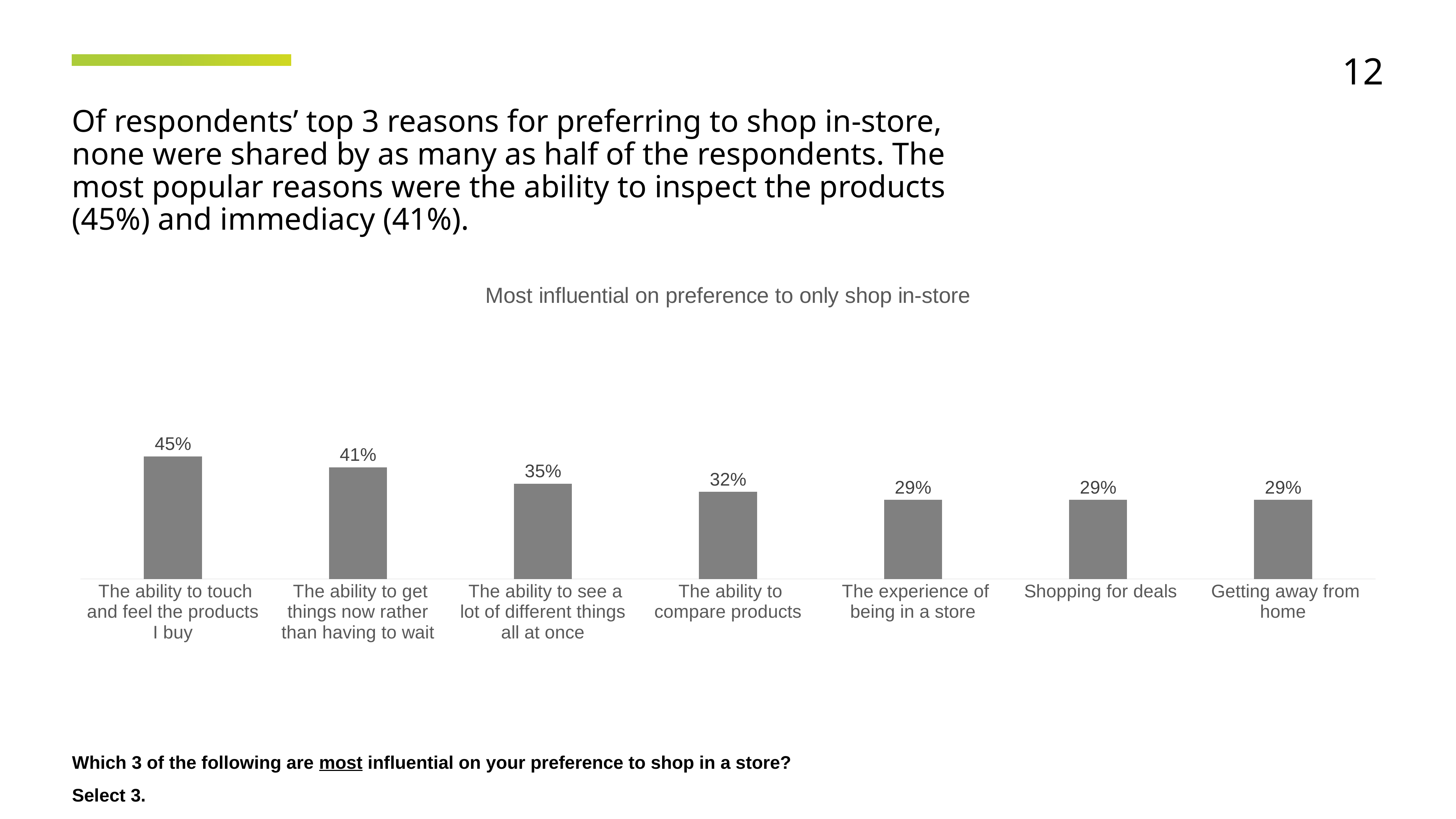
What is the title of the chart? Most influential on preference to only shop in-store What is the difference between 'The ability to touch and feel the products I buy' and 'The ability to see a lot of different things all at once'? 10% Which is larger: 'The ability to see a lot of different things all at once' or 'The experience of being in a store'? The ability to see a lot of different things all at once What is the value for 'Shopping for deals'? 29% What is the difference between 'The ability to get things now rather than having to wait' and 'The ability to compare products'? 9% What percentage of respondents chose 'The ability to touch and feel the products I buy'? 45% What is the value for 'The ability to get things now rather than having to wait'? 41% How many categories are shown in the chart? 7 Do the values rise or fall moving from left to right across the chart? Fall Which reason has the highest value in the chart? The ability to touch and feel the products I buy What type of chart is shown on the slide? Bar chart What is the value for 'The ability to compare products'? 32%